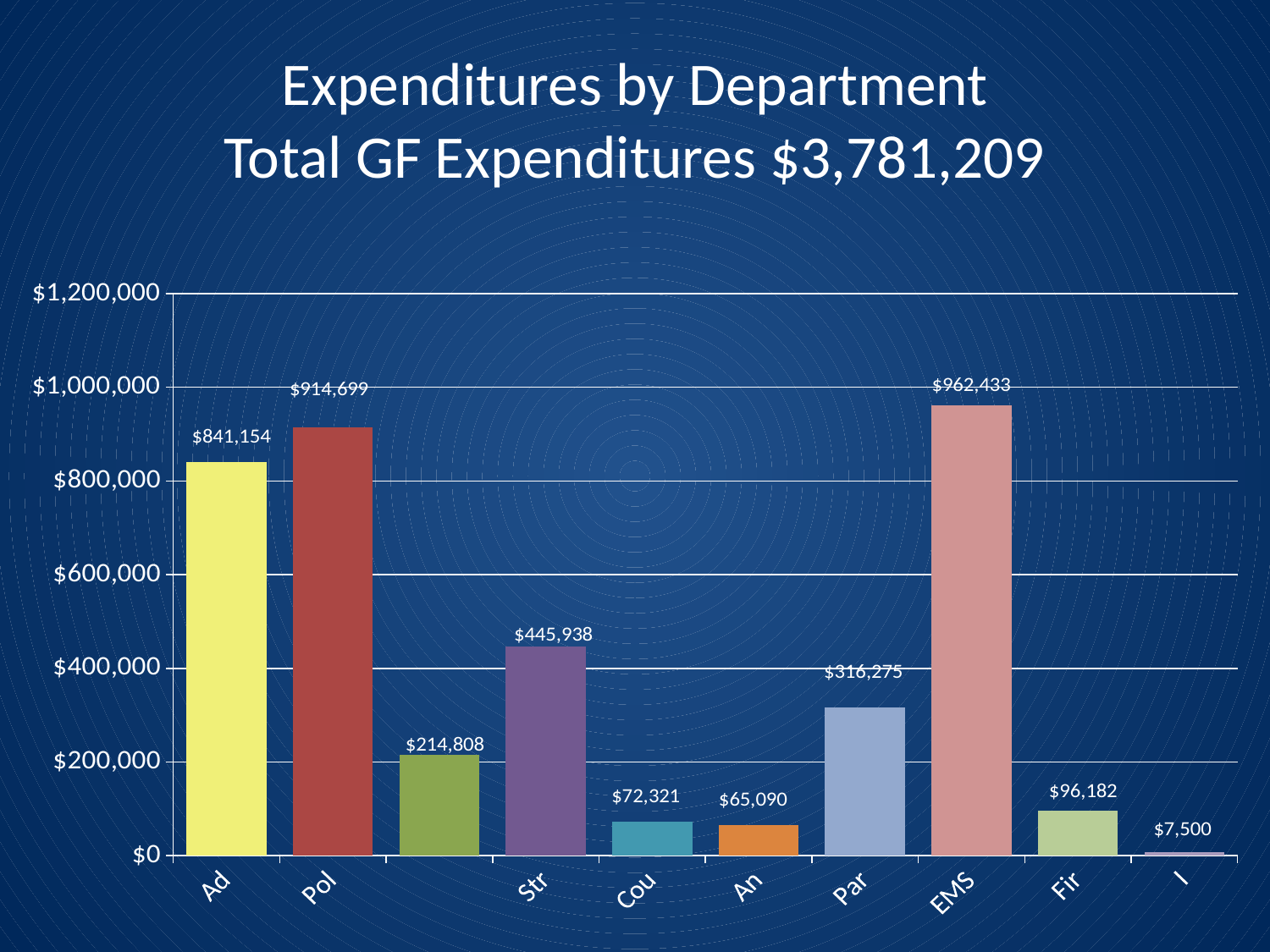
Which department has the lowest expenditure? I What total GF expenditures figure is stated in the chart title? $3,781,209 How many bars are shown in the chart? 10 What is the value for Str? $445,938 Is the value for Fir greater or less than $200,000? less Which is larger, the value for Cou or the value for An? Cou Which department has the highest expenditure? EMS What is the value for EMS? $962,433 What is the difference between the values for EMS and Pol? $47,734 What kind of chart is shown on the slide? bar chart What is the value for Par? $316,275 What is the difference between the values for Pol and Ad? $73,545